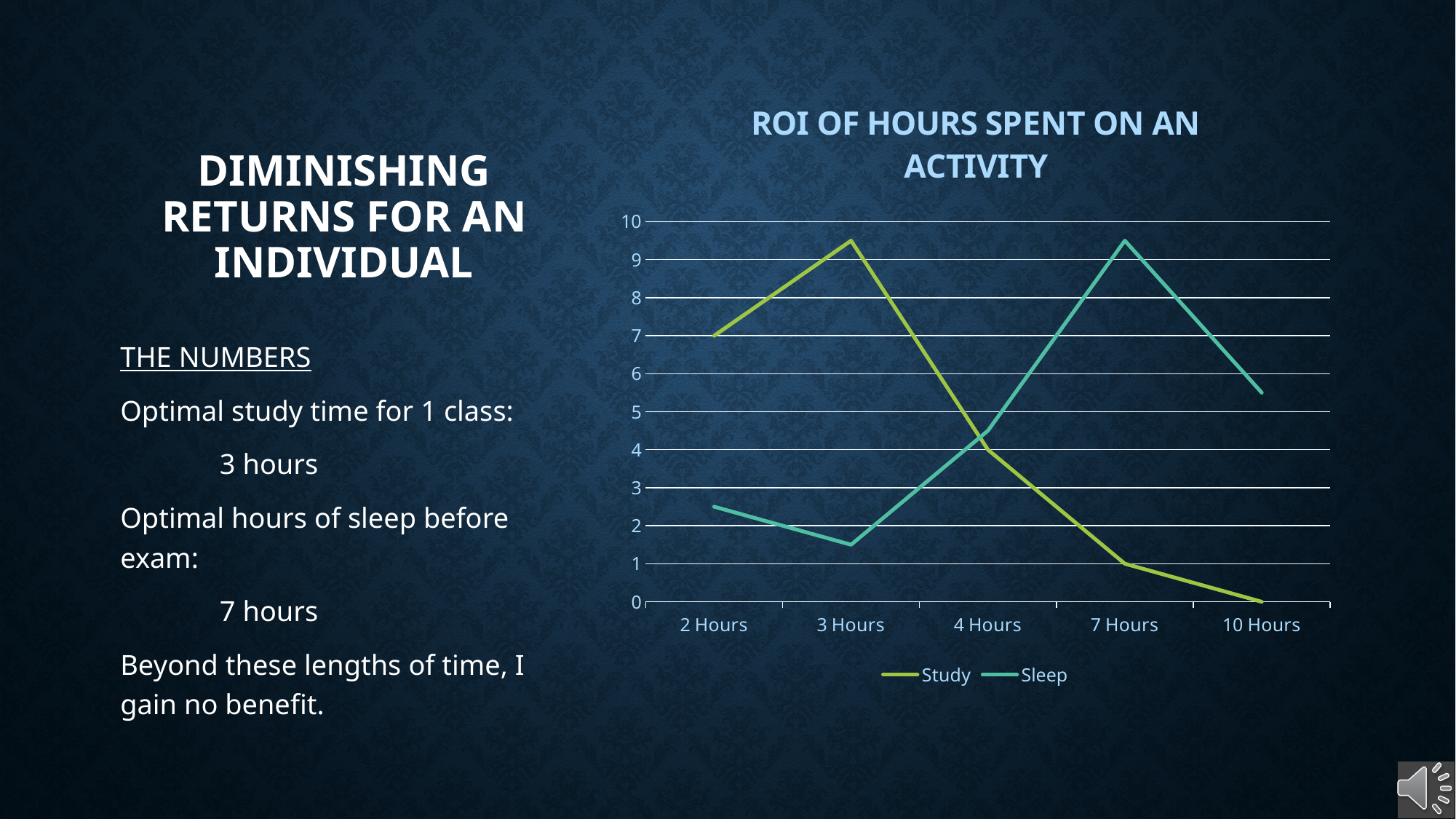
How many categories are shown on the x axis of the chart? 5 How many series does the chart's legend list? 2 At which category does the Sleep series reach its highest value? 7 Hours Does the Study series rise or fall from 3 Hours to 10 Hours? fall What is the Study value at 10 Hours? 0 Is the Sleep value at 7 Hours greater or less than 9? greater At which category does the Study series reach its lowest value? 10 Hours What kind of chart is shown on the slide? line chart What is the Study value at 2 Hours? 7 Which series has the larger value at 3 Hours, Study or Sleep? Study What is the title of the chart? ROI of Hours Spent on an Activity